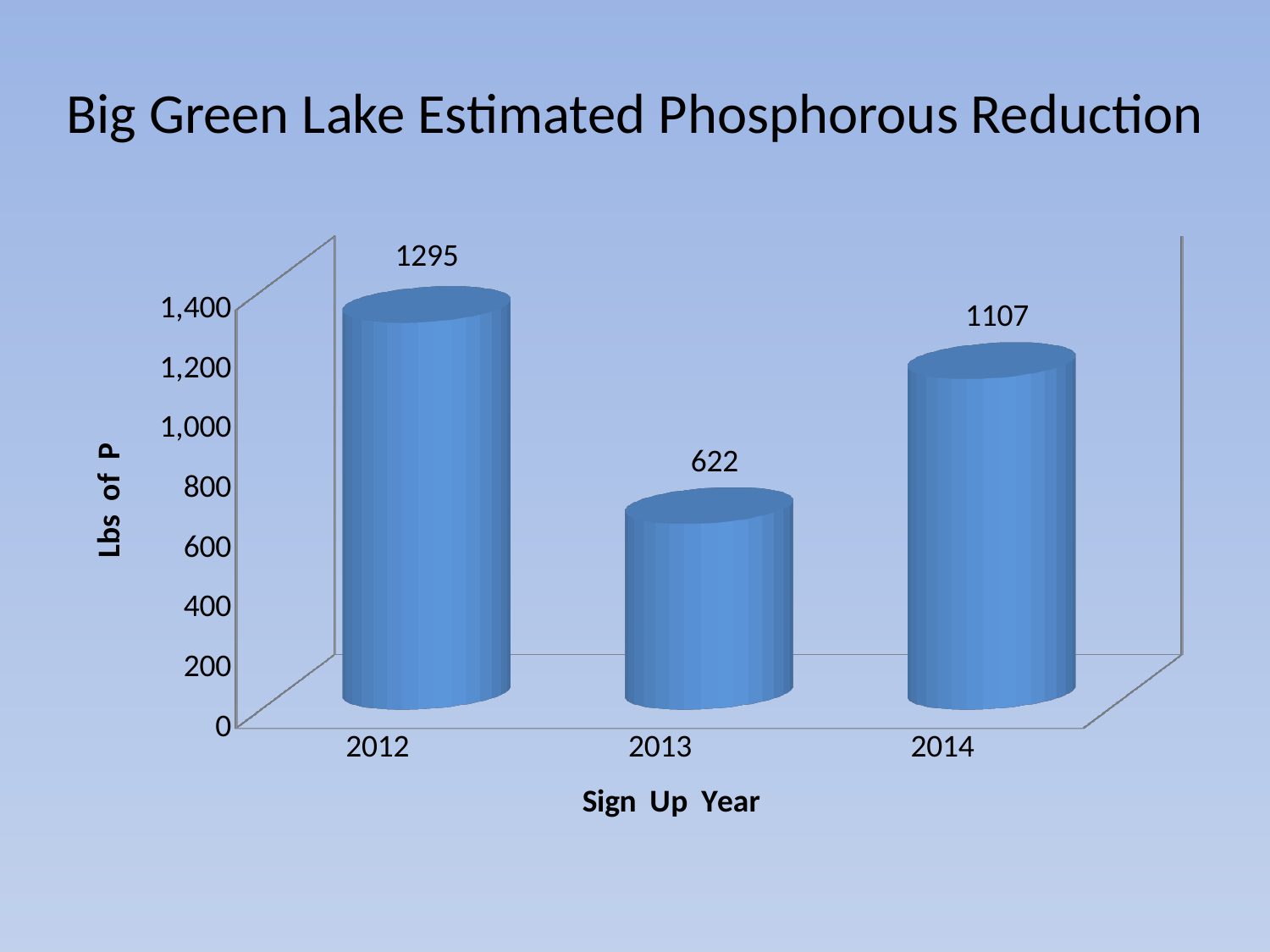
Is the value for 2013 greater or less than 800? less What is the estimated phosphorous reduction for sign up year 2013? 622 What is the difference between the values for 2012 and 2014? 188 How many sign up years are shown on the chart? 3 What is the estimated phosphorous reduction for sign up year 2012? 1295 What is the estimated phosphorous reduction for sign up year 2014? 1107 Which sign up year has the lowest estimated phosphorous reduction? 2013 Which sign up year has the highest estimated phosphorous reduction? 2012 What is the label of the vertical axis? Lbs of P What is the difference between the values for 2012 and 2013? 673 Which is larger, the value for 2013 or the value for 2014? 2014 What kind of chart is shown on the slide? bar chart